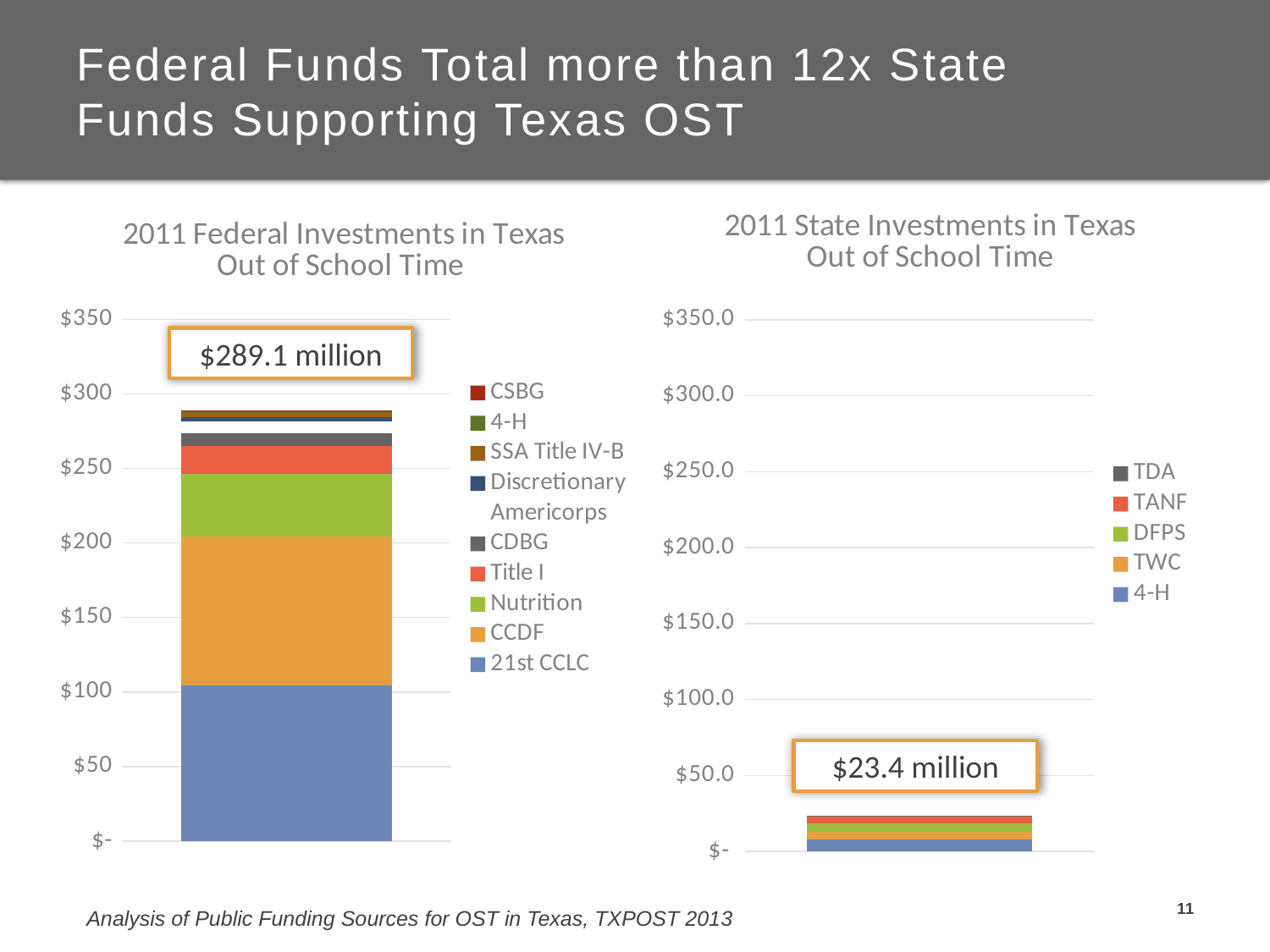
What kind of chart is the '2011 Federal Investments in Texas Out of School Time' chart? stacked bar chart Which total is larger: the federal investments bar or the state investments bar? federal investments How many series does the legend of the '2011 State Investments in Texas Out of School Time' chart list? 5 In the '2011 State Investments in Texas Out of School Time' chart, which series is listed first (at the top) in the legend? TDA In the '2011 State Investments in Texas Out of School Time' chart, is the total of the stacked bar greater or less than $50.0? less How many series does the legend of the '2011 Federal Investments in Texas Out of School Time' chart list? 9 What is the difference between the federal investments total and the state investments total? $265.7 million In the '2011 Federal Investments in Texas Out of School Time' chart, is the total of the stacked bar greater or less than $250? greater In the '2011 Federal Investments in Texas Out of School Time' chart, which series is shown in blue at the bottom of the stacked bar? 21st CCLC In the '2011 State Investments in Texas Out of School Time' chart, what is the total value of the stacked bar? $23.4 million In the '2011 Federal Investments in Texas Out of School Time' chart, what is the total value of the stacked bar? $289.1 million How many bars are plotted in the '2011 Federal Investments in Texas Out of School Time' chart? 1